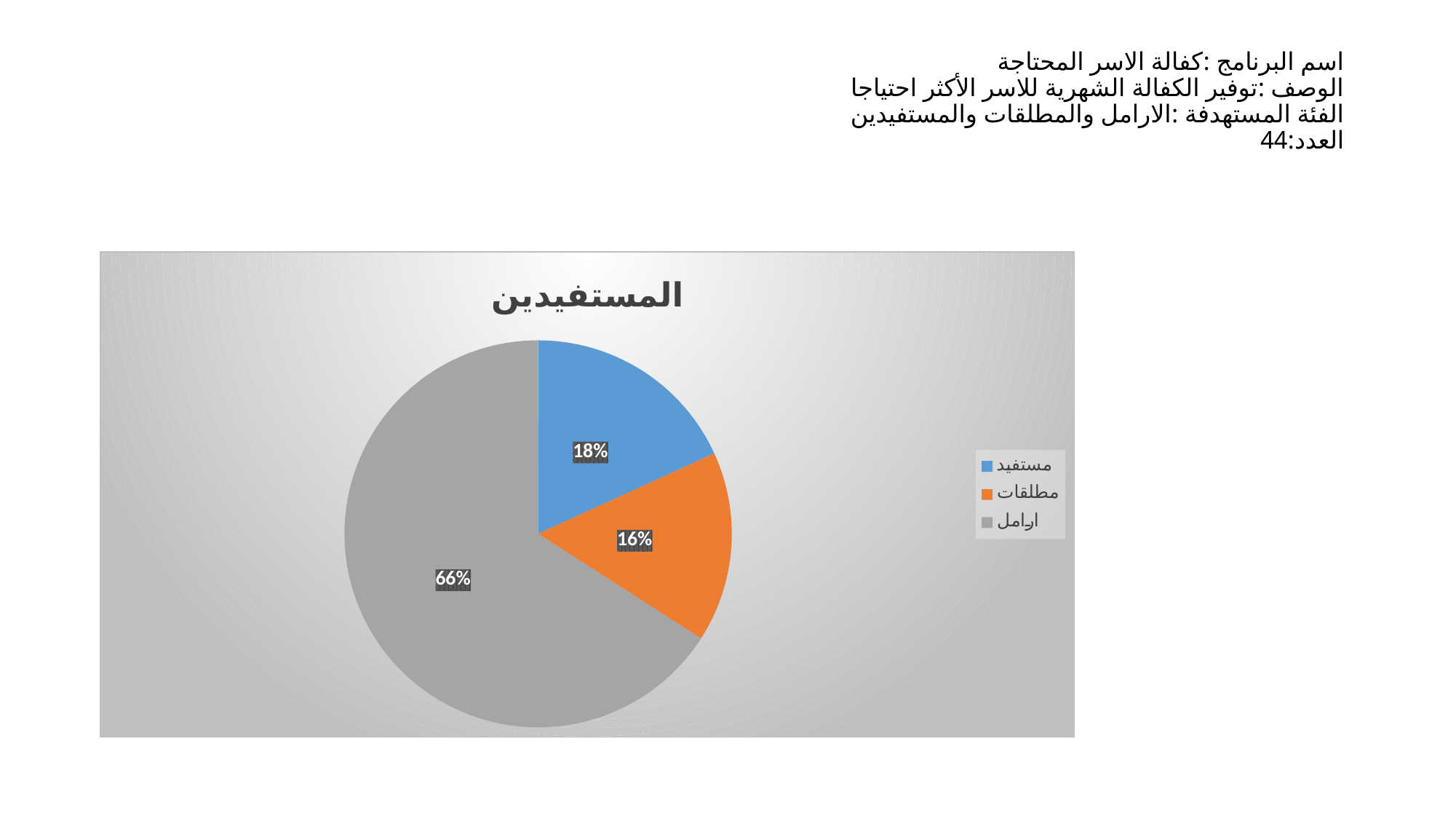
How many slices does the pie chart have? 3 What percentage of the pie does the مطلقات slice represent? 16% What percentage of the pie does the ارامل slice represent? 66% Which category has the largest share of the pie? ارامل What kind of chart is shown on the slide? pie chart What percentage of the pie does the مستفيد slice represent? 18% Which is larger, the share for مستفيد or the share for مطلقات? مستفيد What is the title of the chart? المستفيدين Which category has the smallest share of the pie? مطلقات What colour is the ارامل slice in the pie chart? gray How many entries does the legend list? 3 What is the difference in percentage points between the ارامل slice and the مستفيد slice? 48